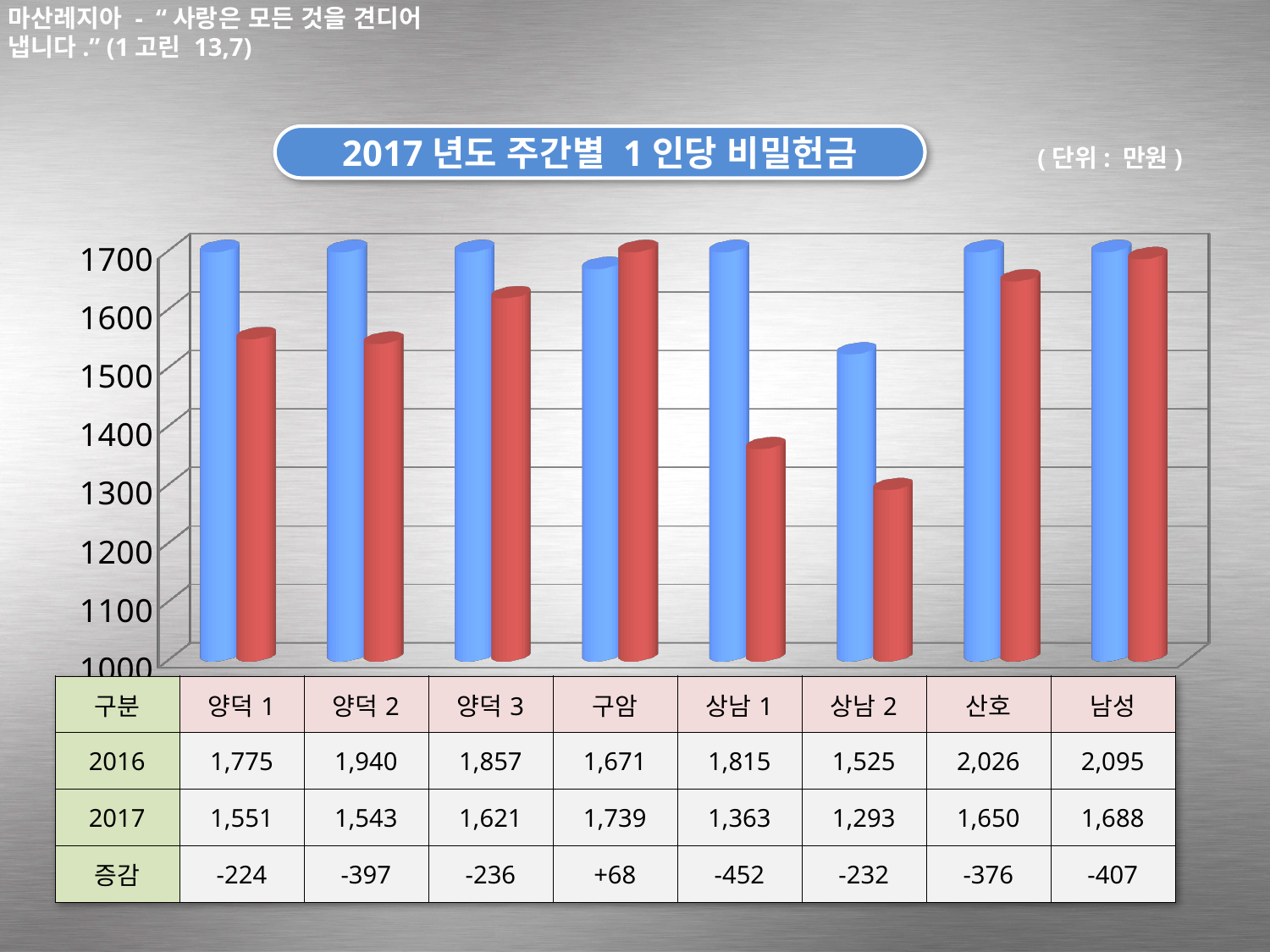
Which category has the lowest 2016 value? 상남 2 What kind of chart is shown on the slide? bar chart Which category has the lowest 2017 value? 상남 2 Which category is the only one whose value increased from 2016 to 2017? 구암 What is the 2017 value for 구암? 1,739 How many categories are shown along the x axis of the chart? 8 Which is larger, the 2017 value for 양덕 2 or the 2017 value for 양덕 3? 양덕 3 Which category has the highest 2017 value? 구암 What unit is stated for the values in the chart? 만원 Is the 2017 value for 상남 1 greater or less than 1400? less By how much did the value for 상남 1 decrease from 2016 to 2017? 452 What is the 2016 value for 산호? 2,026